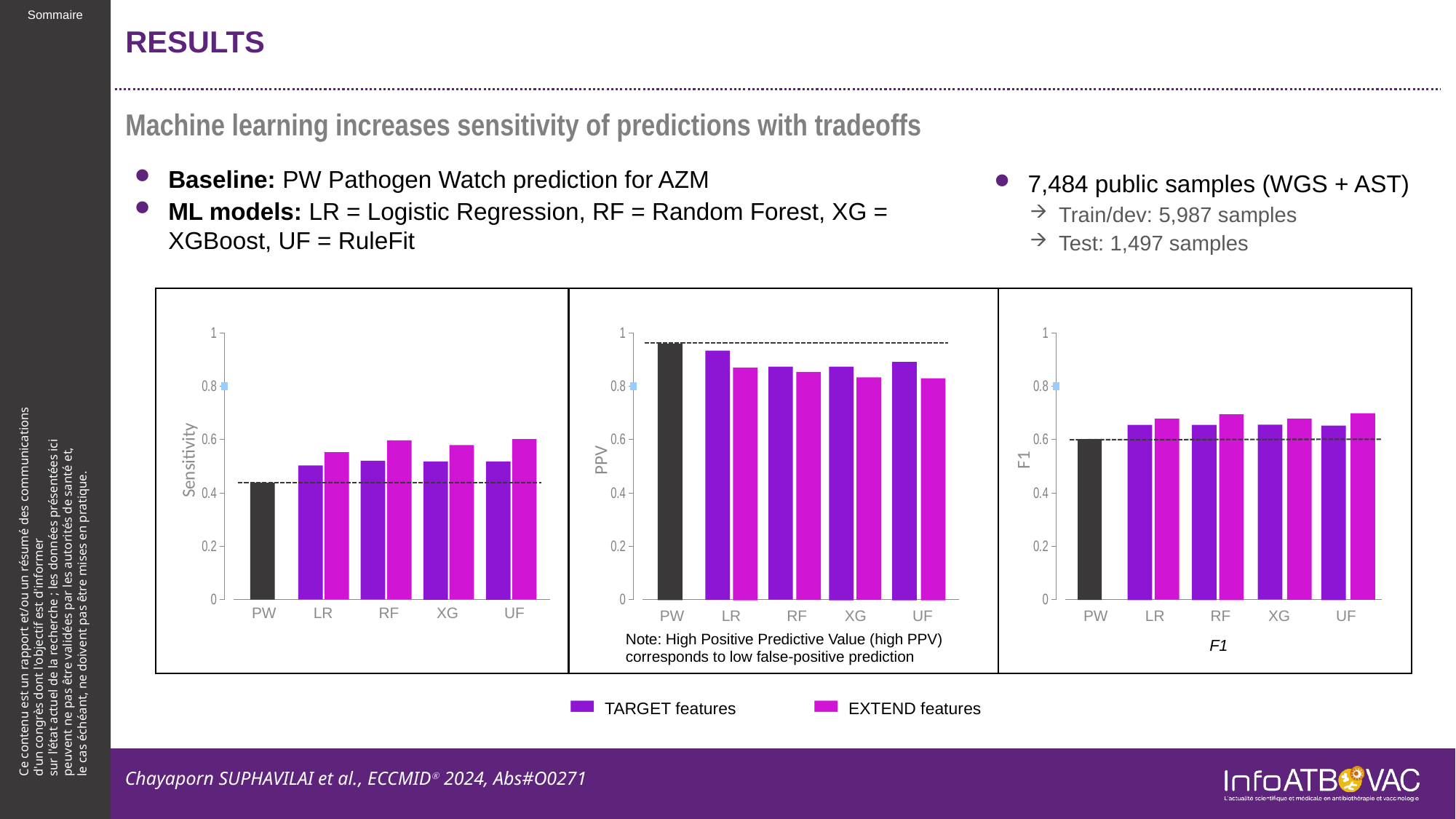
In the Sensitivity chart, which category has the lowest bar? PW In the Sensitivity chart, which is larger: the PW bar or the TARGET features bar for LR? TARGET features bar for LR In the PPV chart, which is larger: the PW bar or the EXTEND features bar for UF? PW bar How many categories are shown on the x axis of the PPV chart? 5 In the F1 chart, is the EXTEND features value for UF greater or less than 0.8? less What are the two series named in the legend below the charts? TARGET features and EXTEND features In the Sensitivity chart, is the TARGET features value for LR greater or less than 0.4? greater In the PPV chart, which category has the highest bar? PW How many series does the legend below the charts list? 2 In the Sensitivity chart, is the value for PW greater or less than 0.6? less What kind of chart is the Sensitivity chart on the left? bar chart